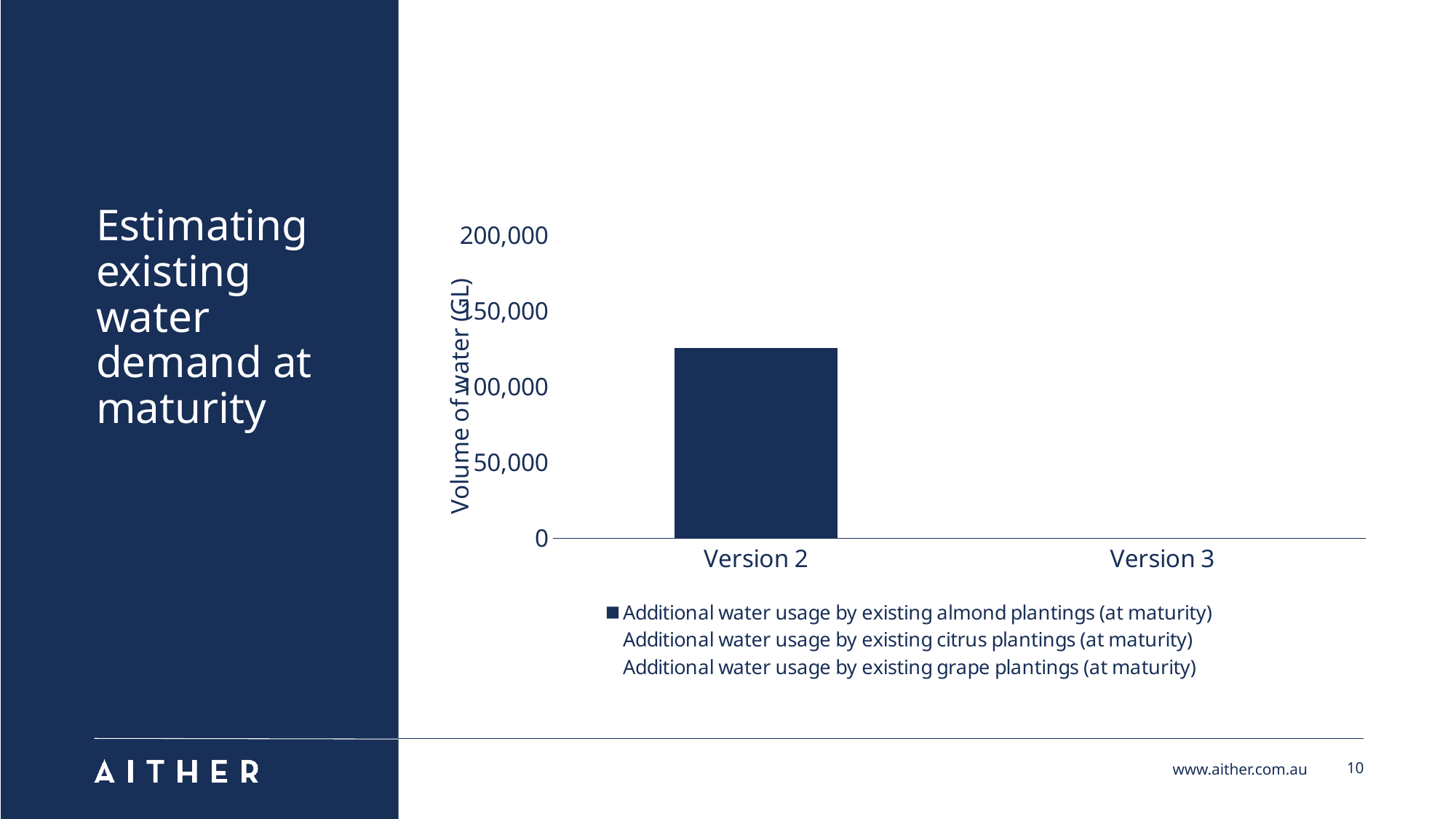
What kind of chart is shown on the slide? Bar chart Is the value for Version 2 (additional water usage by existing almond plantings) greater or less than 100,000? greater What is the highest value shown on the vertical axis? 200,000 Is the value for Version 2 (additional water usage by existing almond plantings) greater or less than 150,000? less What is the label on the vertical axis? Volume of water (GL) What is the first series listed in the legend? Additional water usage by existing almond plantings (at maturity) Which category has the highest plotted value? Version 2 Which category has the larger plotted value, Version 2 or Version 3? Version 2 How many series does the legend list? 3 How many categories are shown on the x axis? 2